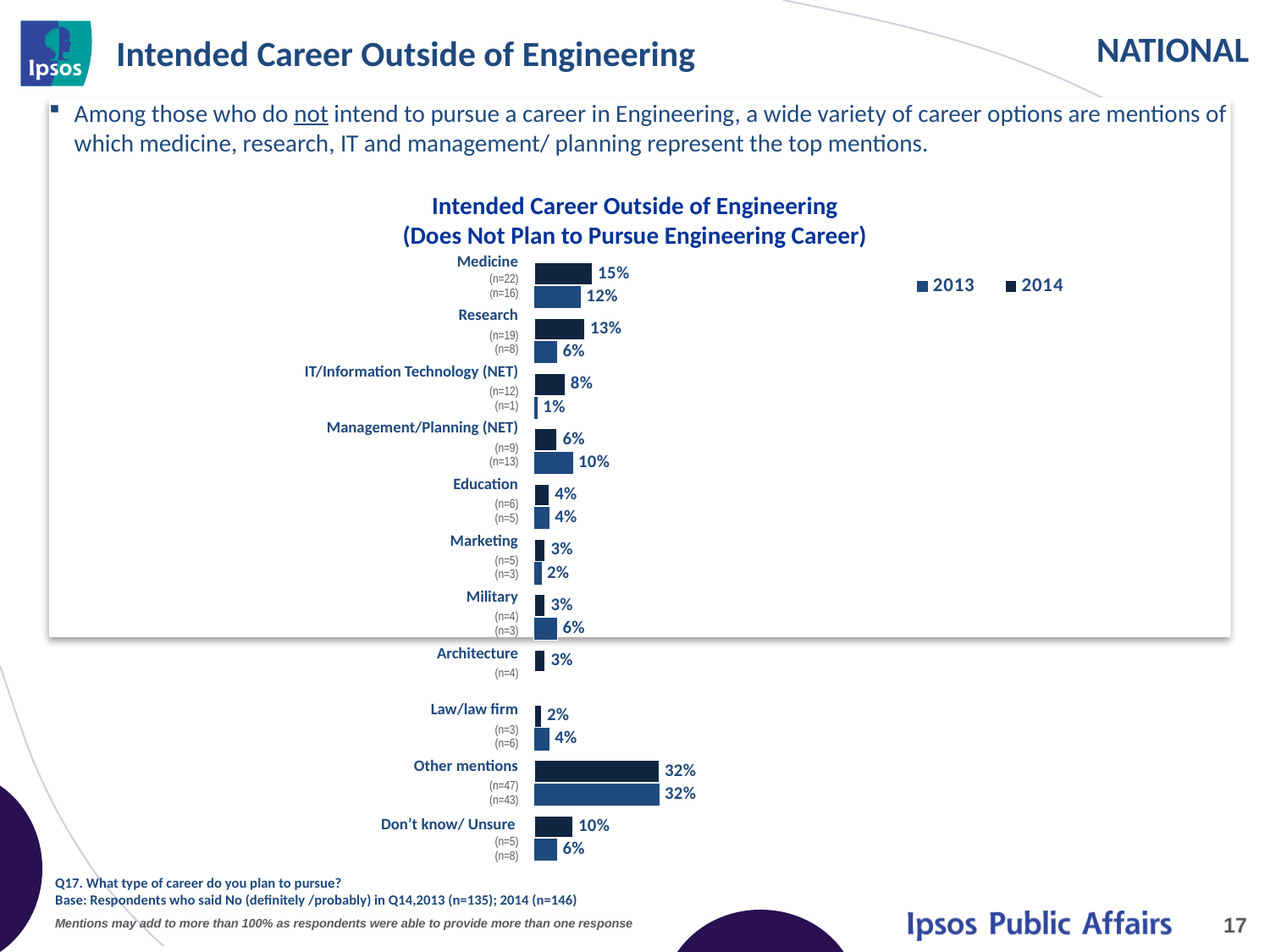
What type of chart is shown on the slide? bar chart What are the two years listed in the chart legend? 2013 and 2014 What is the value for Management/Planning (NET) in 2013? 10% How many series does the chart legend list? 2 Which category has the lowest value in 2013? IT/Information Technology (NET) What is the difference between the 2014 and 2013 values for Research? 7% Which category has the highest value in 2014? Other mentions What is the value for Other mentions in 2013? 32% What is the value for Education in 2014? 4% What is the value for Medicine in 2014? 15% Which is larger for Military: the 2013 value or the 2014 value? 2013 How many career categories are shown on the chart? 11